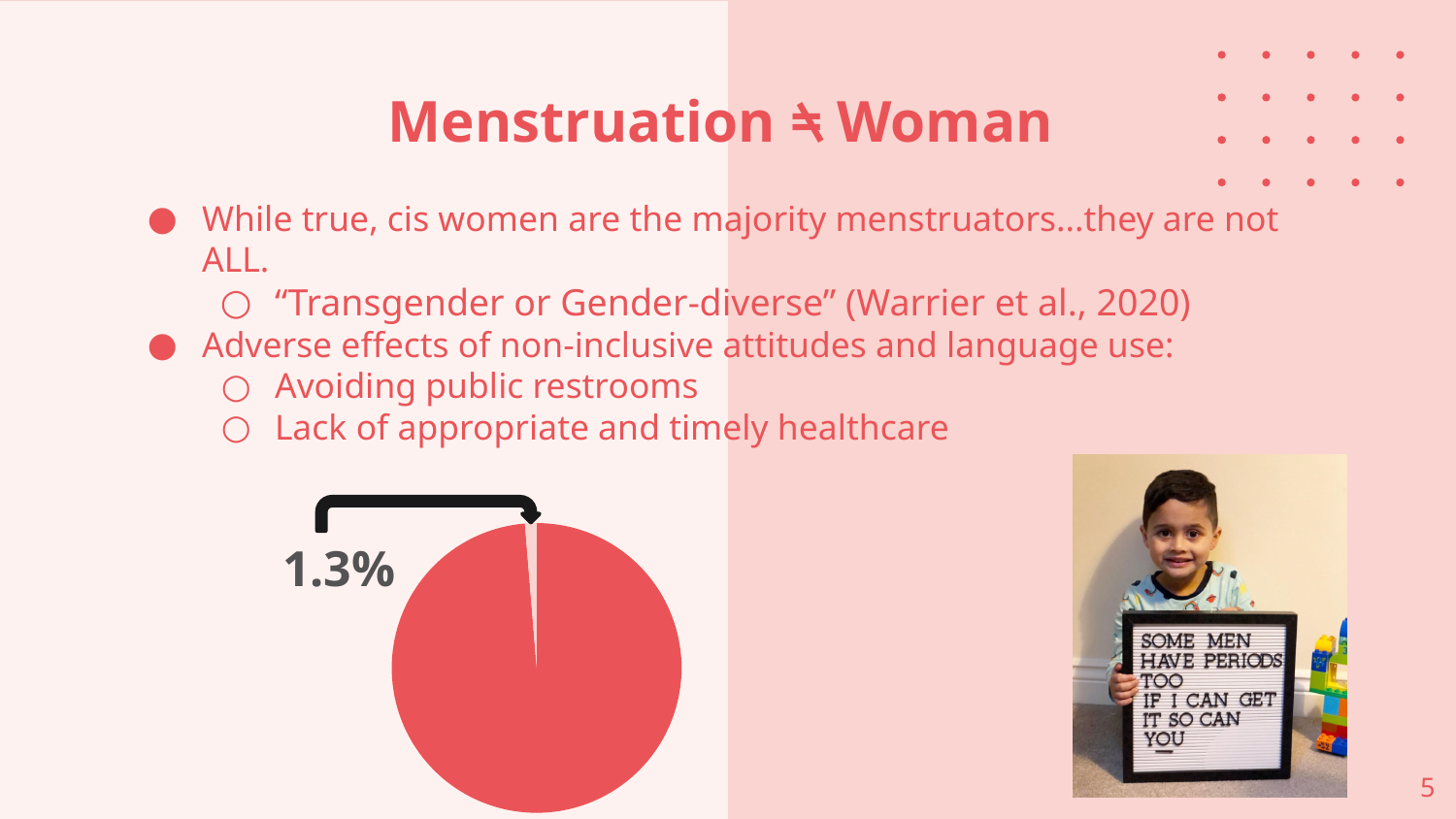
How many slices does the pie chart have? 2 What share of the pie does the small slice with the arrow pointing to it represent? 1.3% What kind of chart is shown on the slide? pie chart What colour is the large slice of the pie chart? red Is the slice labeled 1.3% the larger or the smaller slice of the pie chart? smaller What value is printed next to the small slice of the pie chart? 1.3% Does the pie chart have a legend? No